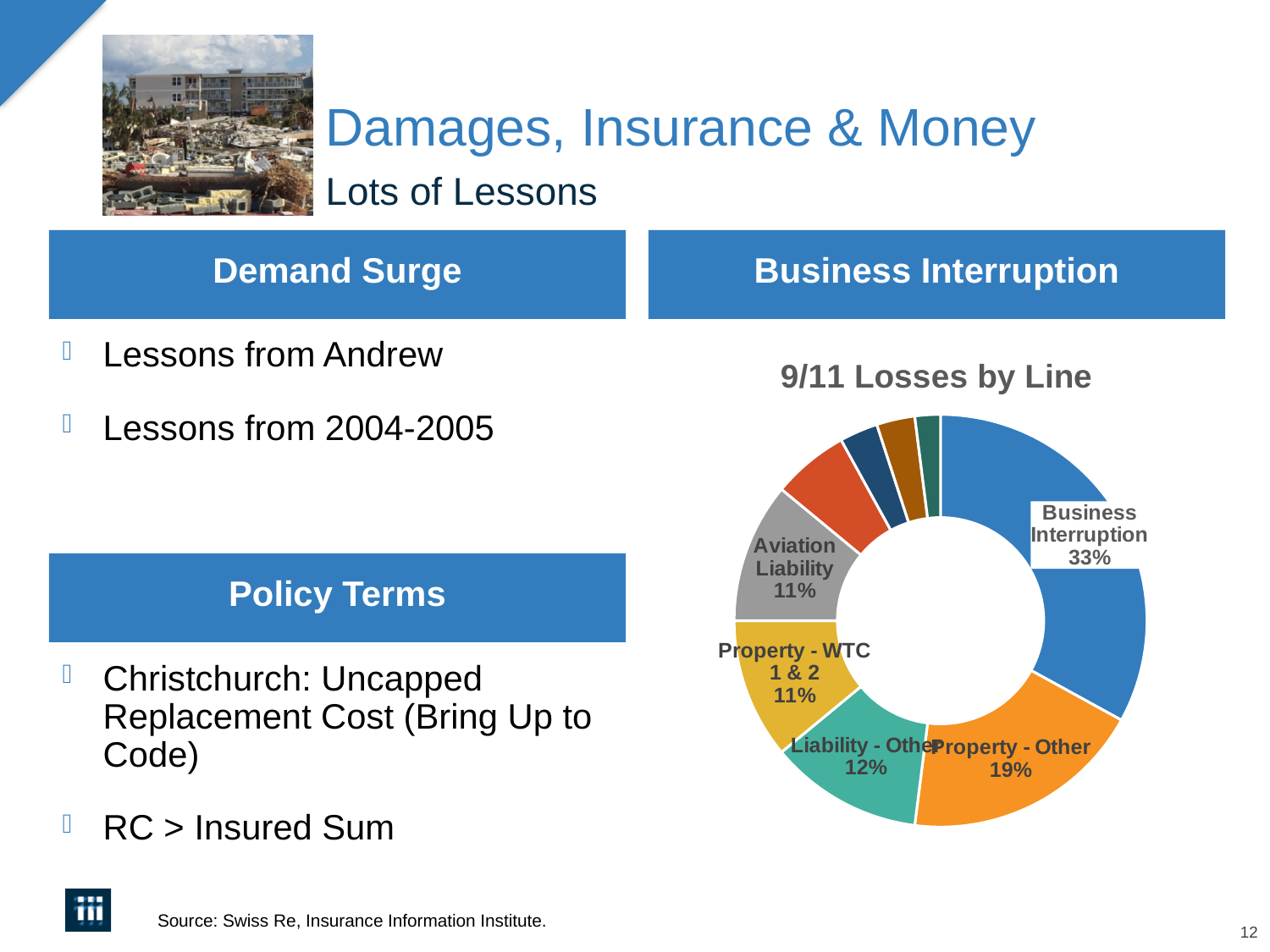
In the 9/11 Losses by Line chart, what share is Business Interruption? 33% In the 9/11 Losses by Line chart, how many percentage points larger is Business Interruption than Property - Other? 14 percentage points Which line has the largest share in the 9/11 Losses by Line chart? Business Interruption In the 9/11 Losses by Line chart, what share is Property - Other? 19% What kind of chart is shown under the heading "9/11 Losses by Line"? pie chart (donut) In the 9/11 Losses by Line chart, what share is Property - WTC 1 & 2? 11% How many slices in the 9/11 Losses by Line chart have a printed label and percentage? 5 In the 9/11 Losses by Line chart, what share is Liability - Other? 12% In the 9/11 Losses by Line chart, what do the five labeled slices add up to? 86% In the 9/11 Losses by Line chart, what share is Aviation Liability? 11% What is the title of the chart on the slide? 9/11 Losses by Line In the 9/11 Losses by Line chart, which is larger: Liability - Other or Aviation Liability? Liability - Other